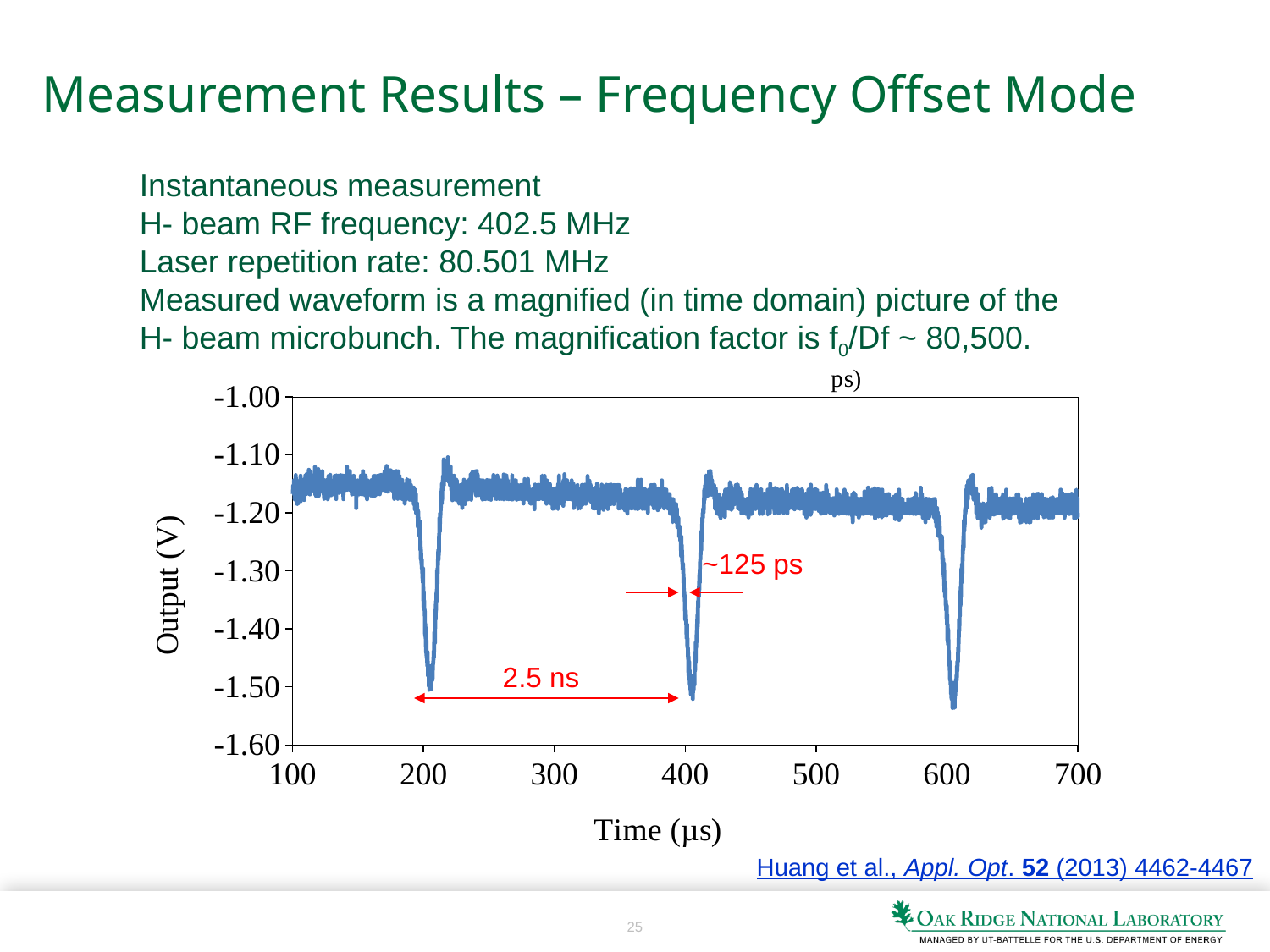
What is the label of the y-axis of the chart? Output (V) What is the label of the x-axis of the chart? Time (µs) What pulse width is annotated on the second dip of the waveform? ~125 ps What is the lowest value shown on the y-axis of the chart? -1.60 How many sharp dips (microbunch pulses) appear in the waveform? 3 Over what range of time does the x-axis of the chart extend? 100 to 700 µs What time separation is annotated between the first two dips in the waveform? 2.5 ns What kind of chart is shown on the slide? line chart Is the baseline output level between the dips greater or less than -1.30 V? greater Is the minimum output of the dip near 600 µs greater or less than -1.40 V? less Is the minimum output of the dip near 200 µs greater or less than -1.30 V? less Is the output at 300 µs greater or less than the output at the bottom of the dip near 400 µs? greater